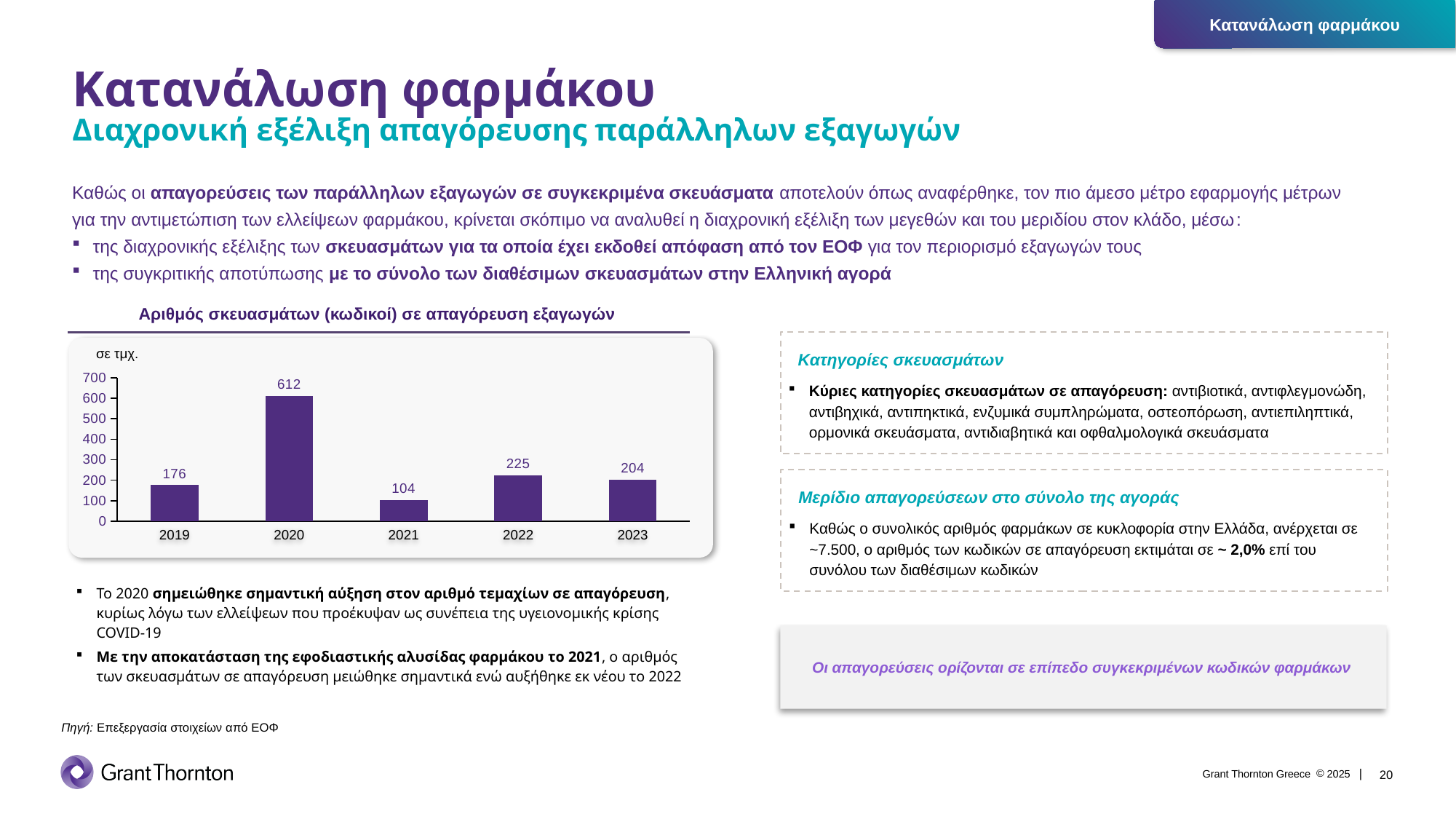
How many years are shown on the x axis of the chart? 5 Which year has the lowest value in the chart? 2021 Is the value for 2019 greater or less than 200? less What is the difference between the values for 2022 and 2023? 21 What is the difference between the values for 2020 and 2021? 508 Which year has the highest value in the chart? 2020 What is the value for 2023 in the chart? 204 Which is larger, the value for 2019 or the value for 2022? 2022 What is the value for 2021 in the chart? 104 What kind of chart is shown on the slide? bar chart What unit label is shown at the top left of the chart? σε τμχ. What is the value for 2020 in the chart 'Αριθμός σκευασμάτων (κωδικοί) σε απαγόρευση εξαγωγών'? 612